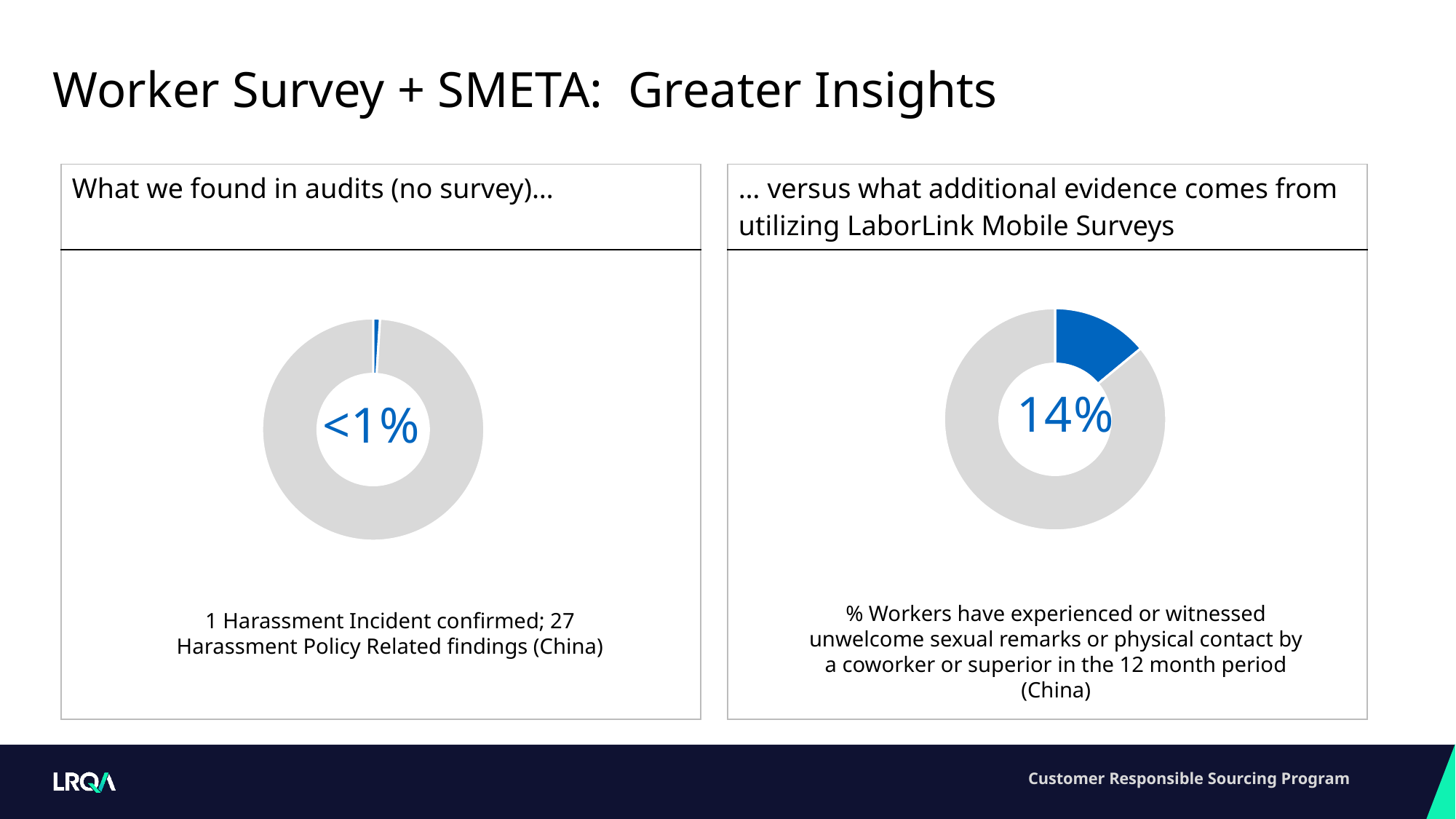
What is the heading above the left donut chart? What we found in audits (no survey)... Which chart shows the larger highlighted share, the left (audits) chart or the right (LaborLink surveys) chart? The right (LaborLink surveys) chart How many donut charts are shown on the slide? 2 What kind of chart is used on the right side of the slide? Donut chart In the right donut chart, what share of the ring is filled in blue? 14% What value is shown in the centre of the left donut chart (What we found in audits)? <1% What value is shown in the centre of the right donut chart (LaborLink Mobile Surveys)? 14% How many harassment incidents were confirmed in audits according to the left chart's caption? 1 What kind of chart is used on the left side of the slide? Donut chart What colour is the highlighted slice in the right donut chart? Blue How many harassment policy related findings are mentioned in the left chart's caption? 27